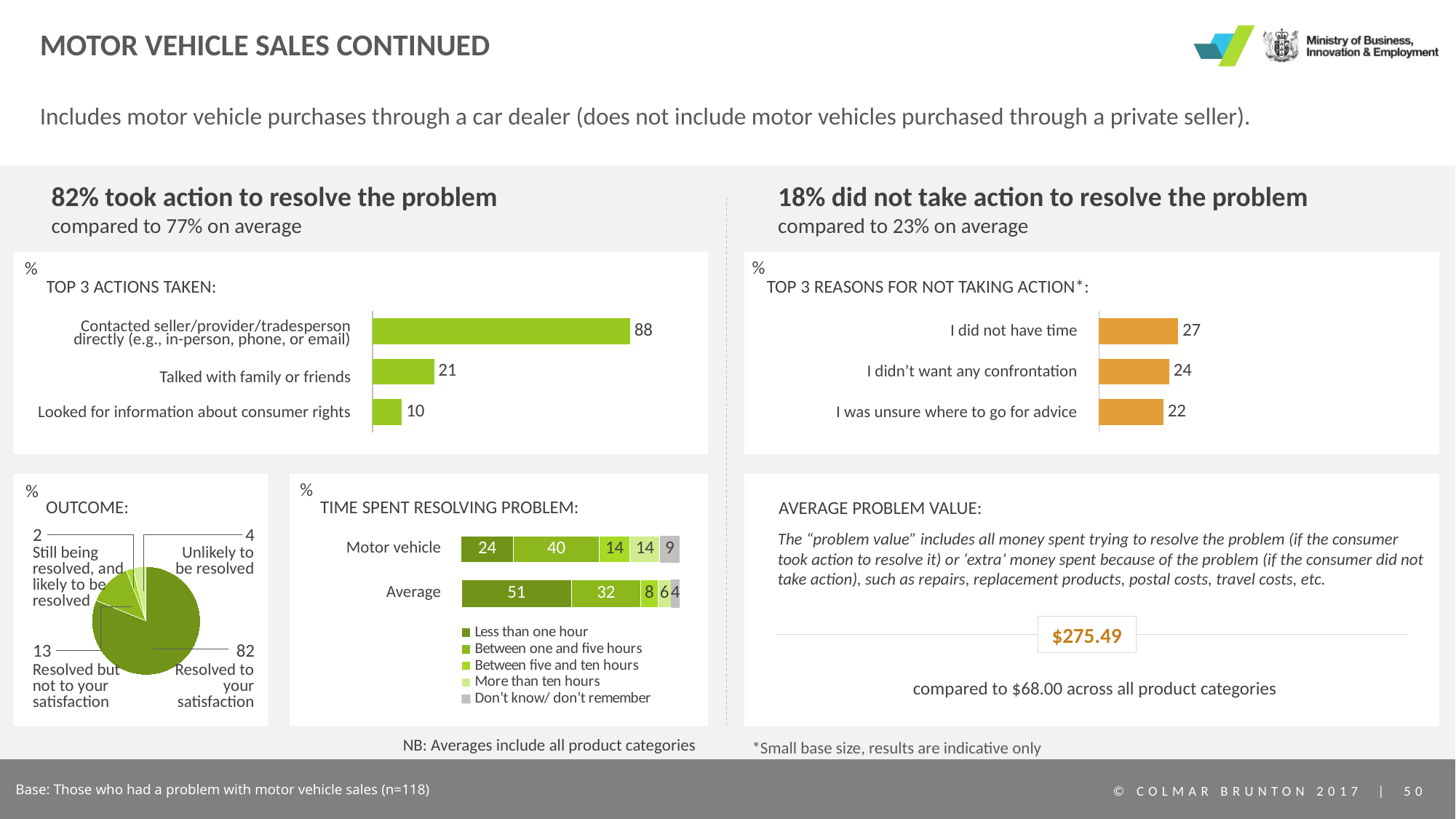
In the 'TOP 3 REASONS FOR NOT TAKING ACTION' chart, what is the value for 'I didn't want any confrontation'? 24 In the 'TIME SPENT RESOLVING PROBLEM' chart, which is larger for 'Less than one hour': 'Motor vehicle' or 'Average'? Average What kind of chart is the 'OUTCOME' chart? Pie chart In the 'TOP 3 REASONS FOR NOT TAKING ACTION' chart, which reason has the highest value? I did not have time In the 'TOP 3 ACTIONS TAKEN' chart, which action has the lowest value? Looked for information about consumer rights In the 'TIME SPENT RESOLVING PROBLEM' chart, how many series does the legend list? 5 In the 'TOP 3 ACTIONS TAKEN' chart, what is the difference between 'Talked with family or friends' and 'Looked for information about consumer rights'? 11 In the 'OUTCOME' pie chart, which outcome has the smallest slice? Still being resolved, and likely to be resolved In the 'TOP 3 ACTIONS TAKEN' chart, what is the value for 'Contacted seller/provider/tradesperson directly (e.g., in-person, phone, or email)'? 88 In the 'OUTCOME' pie chart, what is the value for 'Resolved to your satisfaction'? 82 In the 'TOP 3 REASONS FOR NOT TAKING ACTION' chart, how many reasons are shown? 3 In the 'TIME SPENT RESOLVING PROBLEM' chart, what is the value for 'Between one and five hours' for 'Motor vehicle'? 40